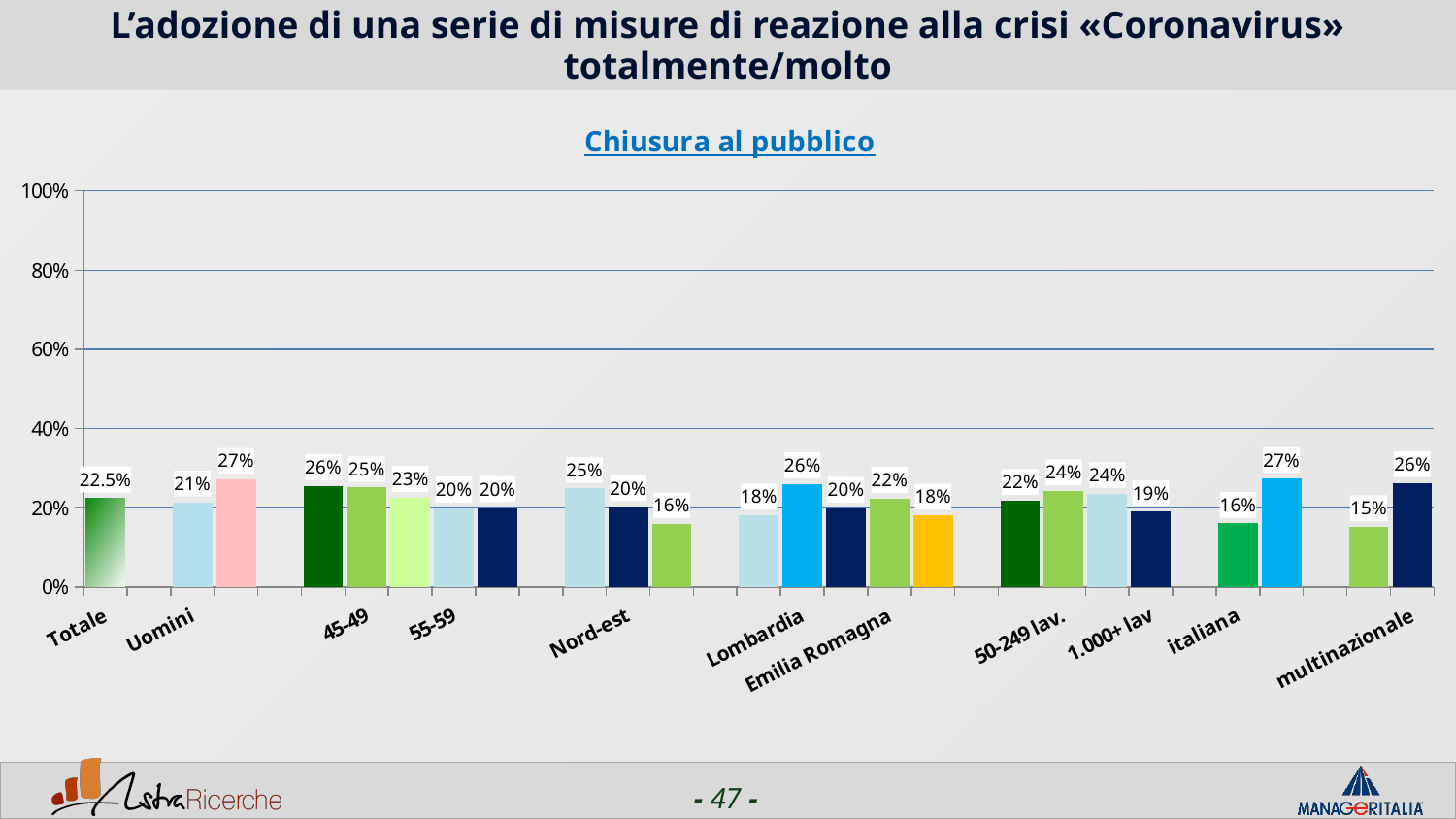
Is the value for Totale greater or less than 40%? less What is the value for multinazionale? 26% What is the value for 1.000+ lav? 19% What type of chart is shown on the slide? bar chart Which is larger, the value for Totale or the value for Uomini? Totale What is the value for Uomini? 21% What is the value for Totale? 22.5% What is the highest value printed on any bar in the chart? 27% What is the title of the chart? Chiusura al pubblico What is the value for Lombardia? 26% What is the difference between the value for Totale and the value for Uomini? 1.5 percentage points What is the value for italiana? 16%